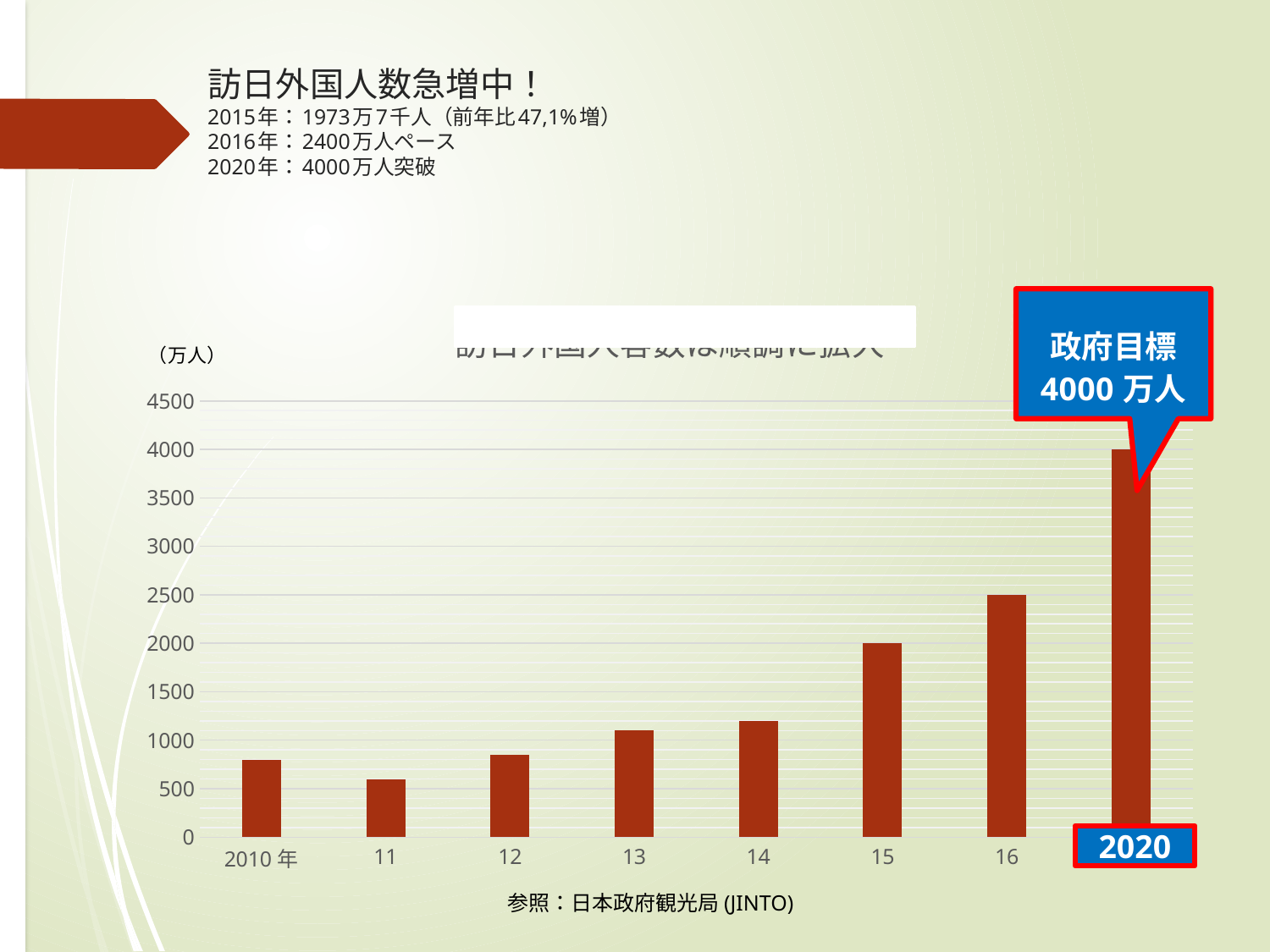
Which year has the lowest bar in the chart? 11 What is the difference between the values for 16 and 15 in the chart (万人)? 500 What unit is shown for the vertical axis of the chart? 万人 Which year has the highest bar in the chart? 2020 What is the value for 15 in the chart (万人)? 2000 Which is larger, the value for 2010年 or the value for 11? 2010年 What is the value shown for 2020 in the chart (万人)? 4000 What kind of chart is shown on the slide? bar chart Is the value for 2010年 greater or less than 1000? less Is the value for 13 greater or less than 1000? greater How many bars (years) are plotted in the chart? 8 What is the value for 16 in the chart (万人)? 2500